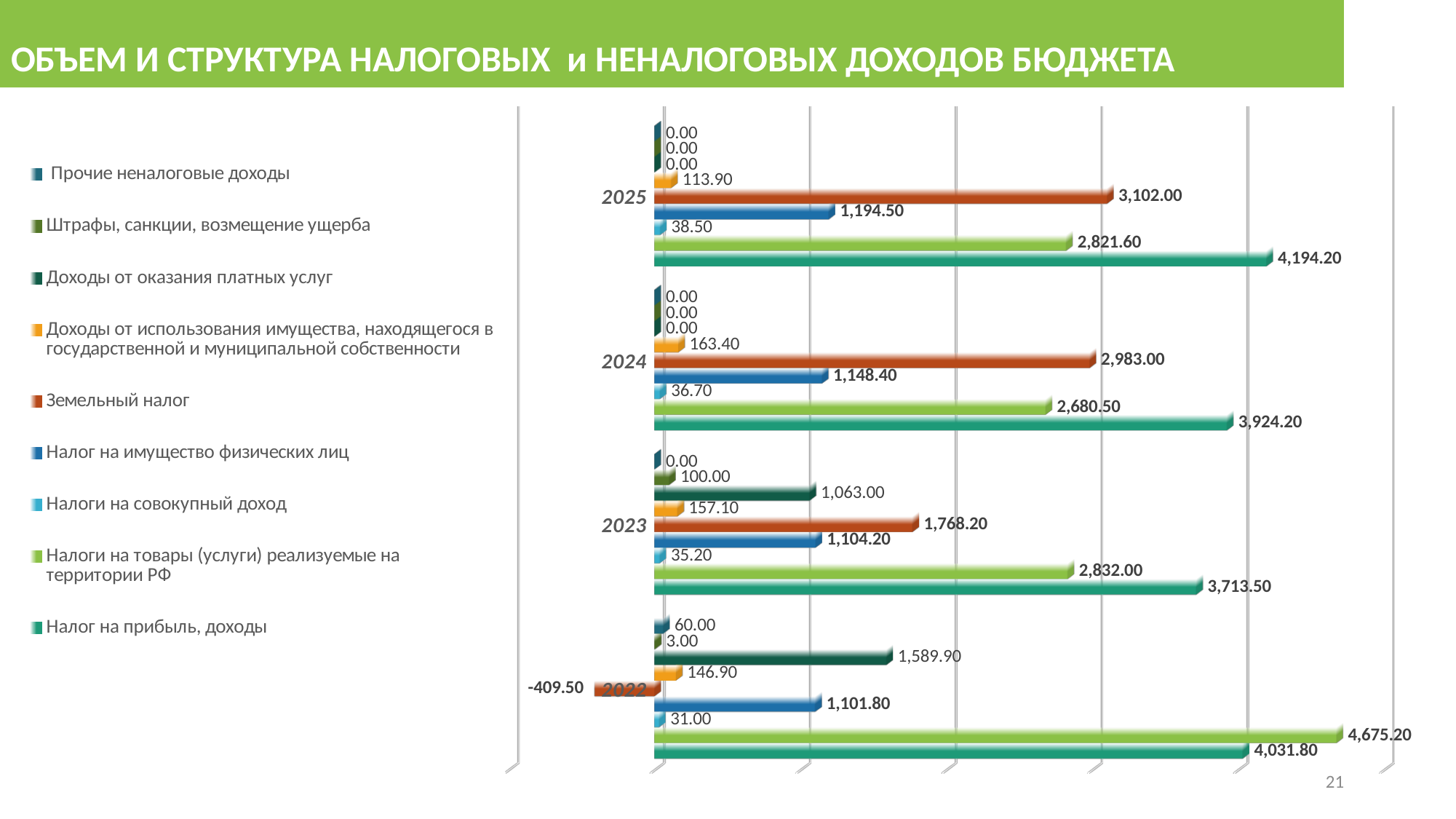
In which year is Налоги на совокупный доход the lowest? 2022 How many series does the legend list? 9 What kind of chart is shown on the slide? Bar chart Which is larger in 2023: Налоги на товары (услуги) реализуемые на территории РФ or Земельный налог? Налоги на товары (услуги) реализуемые на территории РФ What is the value of Доходы от оказания платных услуг for 2023? 1,063.00 What is the value of Земельный налог for 2022? -409.50 Does Налог на имущество физических лиц rise or fall from 2022 to 2025? Rise What is the value of Налог на прибыль, доходы for 2025? 4,194.20 What is the value of Налоги на товары (услуги) реализуемые на территории РФ for 2022? 4,675.20 How many years are shown on the chart? 4 What is the difference between Земельный налог in 2025 and in 2024? 119.00 In which year is Налог на прибыль, доходы the highest? 2025